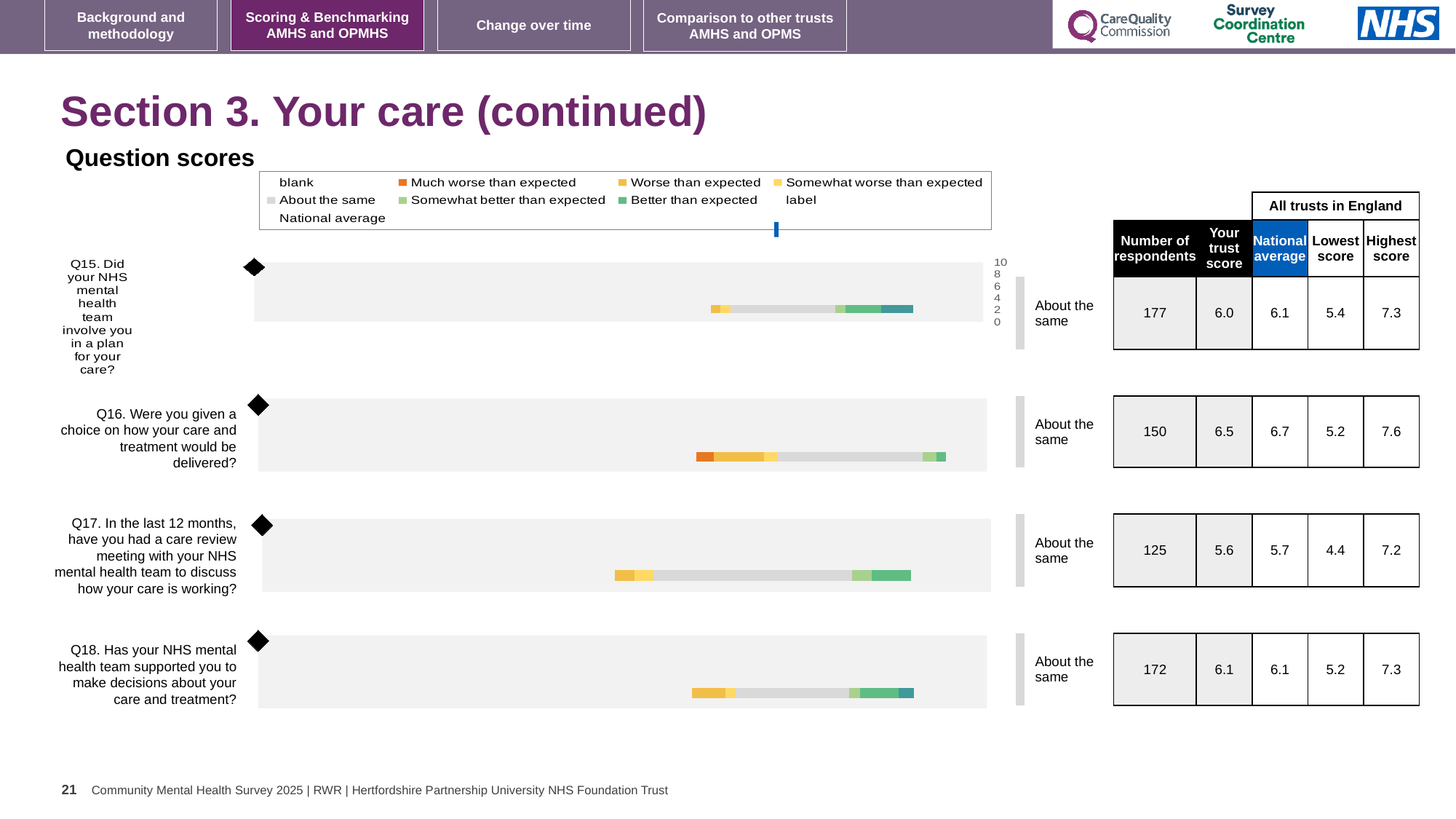
In the legend, what colour represents 'Much worse than expected'? Orange For Q17 (care review meeting in the last 12 months), what is the national average score? 5.7 For Q15 (Did your NHS mental health team involve you in a plan for your care?), what is the number of respondents? 177 Which question has the lowest 'Your trust score' on this slide? Q17 For Q16 (Were you given a choice on how your care and treatment would be delivered?), what is your trust score? 6.5 How many questions (Q15 to Q18) have a score bar plotted on the slide? 4 Which question has the highest 'Your trust score' on this slide? Q16 What kind of chart is used to show the question scores for Q15 to Q18? bar chart For Q18 (Has your NHS mental health team supported you to make decisions about your care and treatment?), what is the lowest score among all trusts in England? 5.2 What benchmark category label is shown next to the bar for Q17? About the same For Q15, which is larger: your trust score or the national average? National average For Q16, what is the difference between the highest score and the lowest score among all trusts in England? 2.4